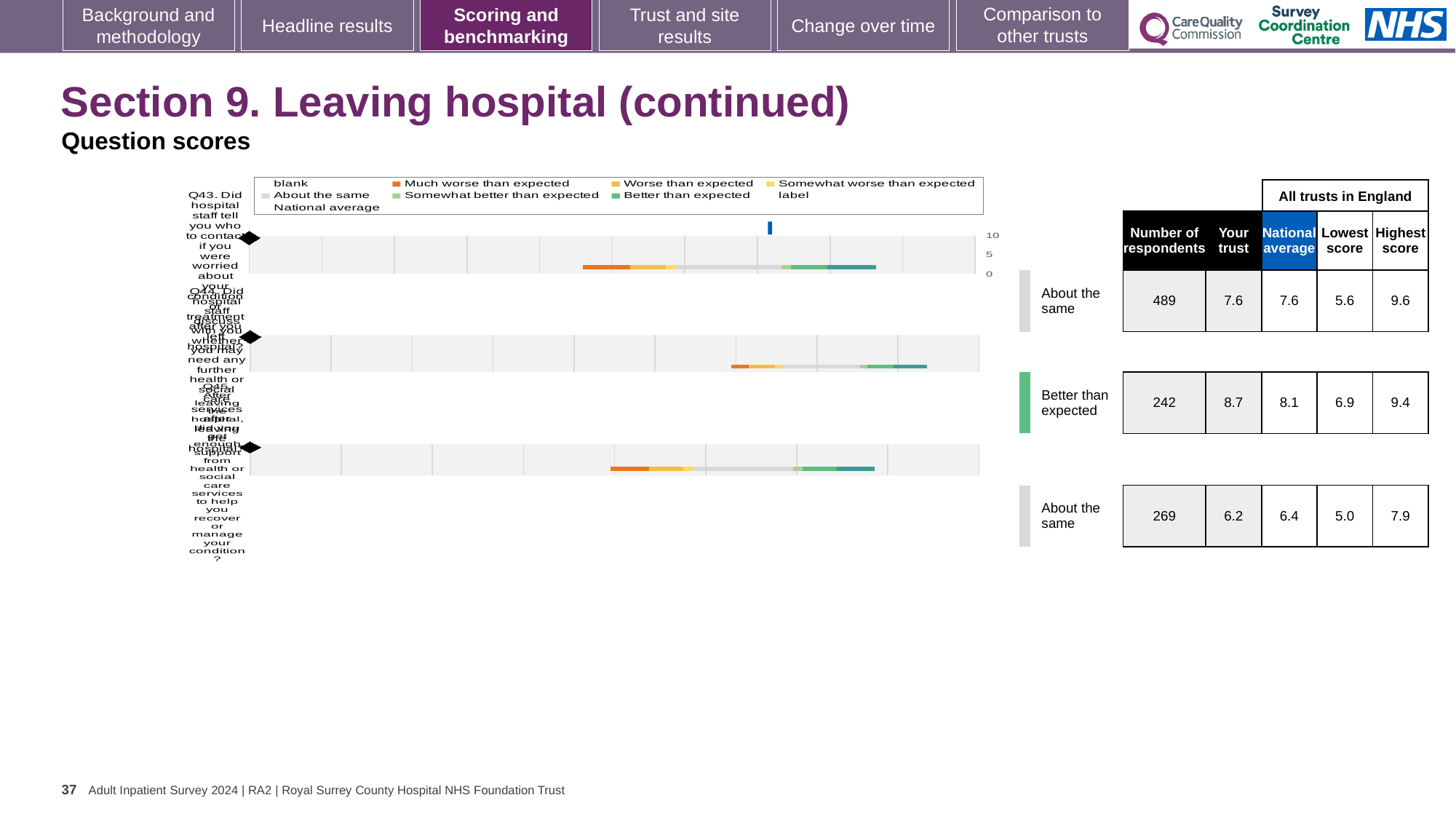
What is the 'Your trust' score for Q43 (Did hospital staff tell you who to contact if you were worried)? 7.6 How many respondents answered Q43? 489 Which question has the lowest 'Your trust' score? Q45 What is the national average score for Q45? 6.4 For Q44, what is the difference between the highest score and the lowest score across all trusts in England? 2.5 In the chart legend, what colour represents 'Much worse than expected'? orange What is the highest tick value shown on the chart's score axis? 10 Which question is rated 'Better than expected'? Q44 What kind of chart is used to show the question scores on this slide? bar chart How many questions (rows) are plotted in the question scores chart? 3 For Q44, which is larger: the 'Your trust' score or the national average? Your trust Which question has the highest 'Your trust' score? Q44